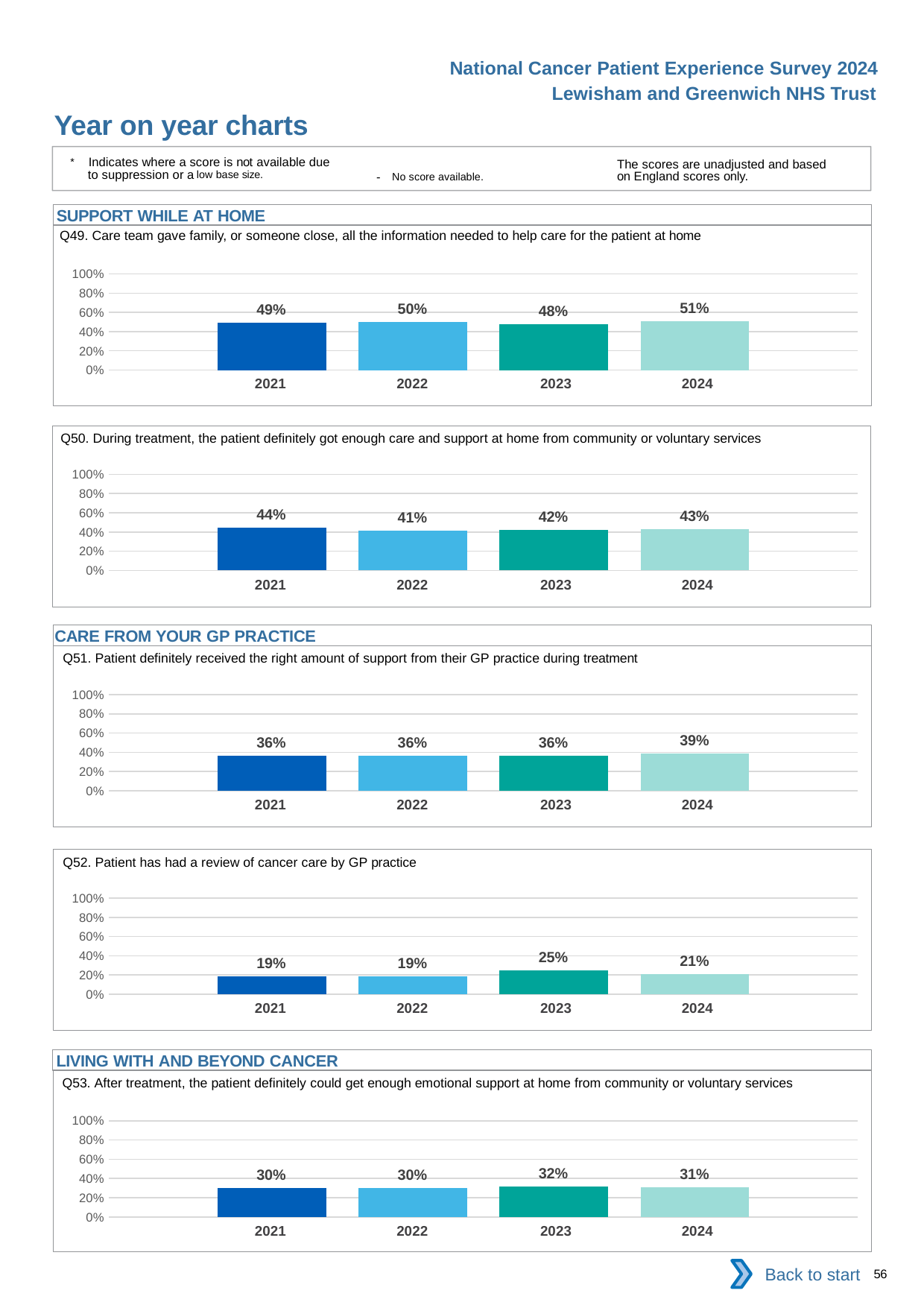
In the Q52 chart, is the value for 2021 greater or less than 40%? less In the Q50 chart, what is the difference between the 2021 and 2022 values? 3% In the Q50 chart, what is the value for 2022? 41% In the Q50 chart, which year has the highest value? 2021 In the Q51 chart, how many years are shown on the x axis? 4 In the Q49 chart, what is the value for 2024? 51% What kind of chart is the Q53 chart? bar chart In the Q52 chart, which year has the highest value? 2023 In the Q49 chart, which year has the lowest value? 2023 In the Q52 chart, what is the difference between the 2023 and 2024 values? 4% In the Q53 chart, which is larger, the value for 2023 or the value for 2024? 2023 In the Q51 chart, what is the value for 2024? 39%